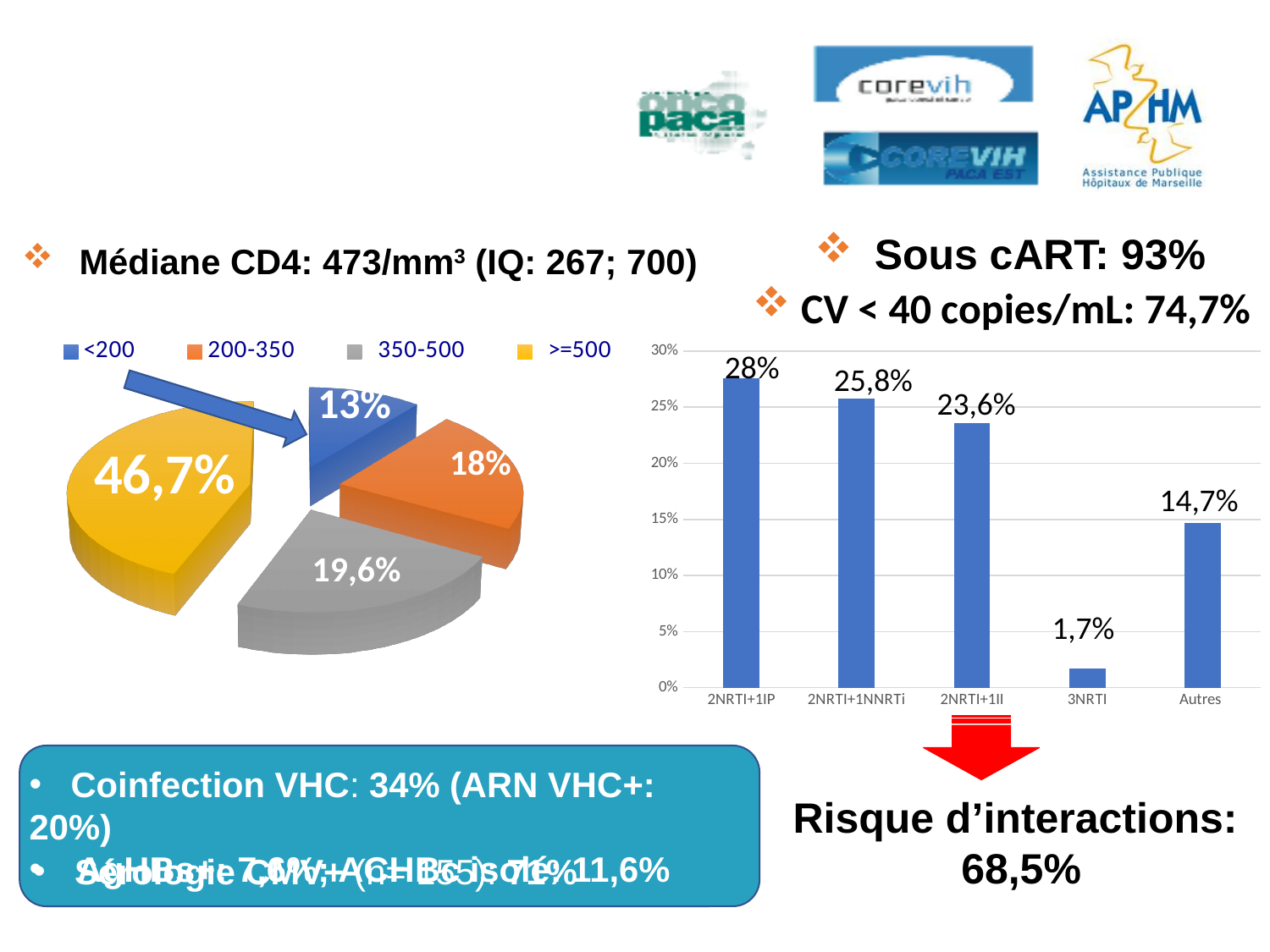
How many categories does the legend of the pie chart on the left list? 4 In the bar chart on the right, which category has the lowest value? 3NRTI In the pie chart on the left, what percentage is shown for the <200 category? 13% What kind of chart is the chart on the right of the slide? Bar chart In the bar chart on the right, what is the value for 3NRTI? 1,7% In the pie chart on the left, what percentage is shown for the >=500 category? 46,7% In the bar chart on the right, what is the difference between 2NRTI+1IP and Autres? 13,3% In the bar chart on the right, which category has the highest value? 2NRTI+1IP In the bar chart on the right, what is the value for 2NRTI+1NNRTi? 25,8% In the pie chart on the left, which category has the smallest slice? <200 In the pie chart on the left, what is the difference between the 350-500 slice and the 200-350 slice? 1,6% In the pie chart on the left, which category has the largest slice? >=500